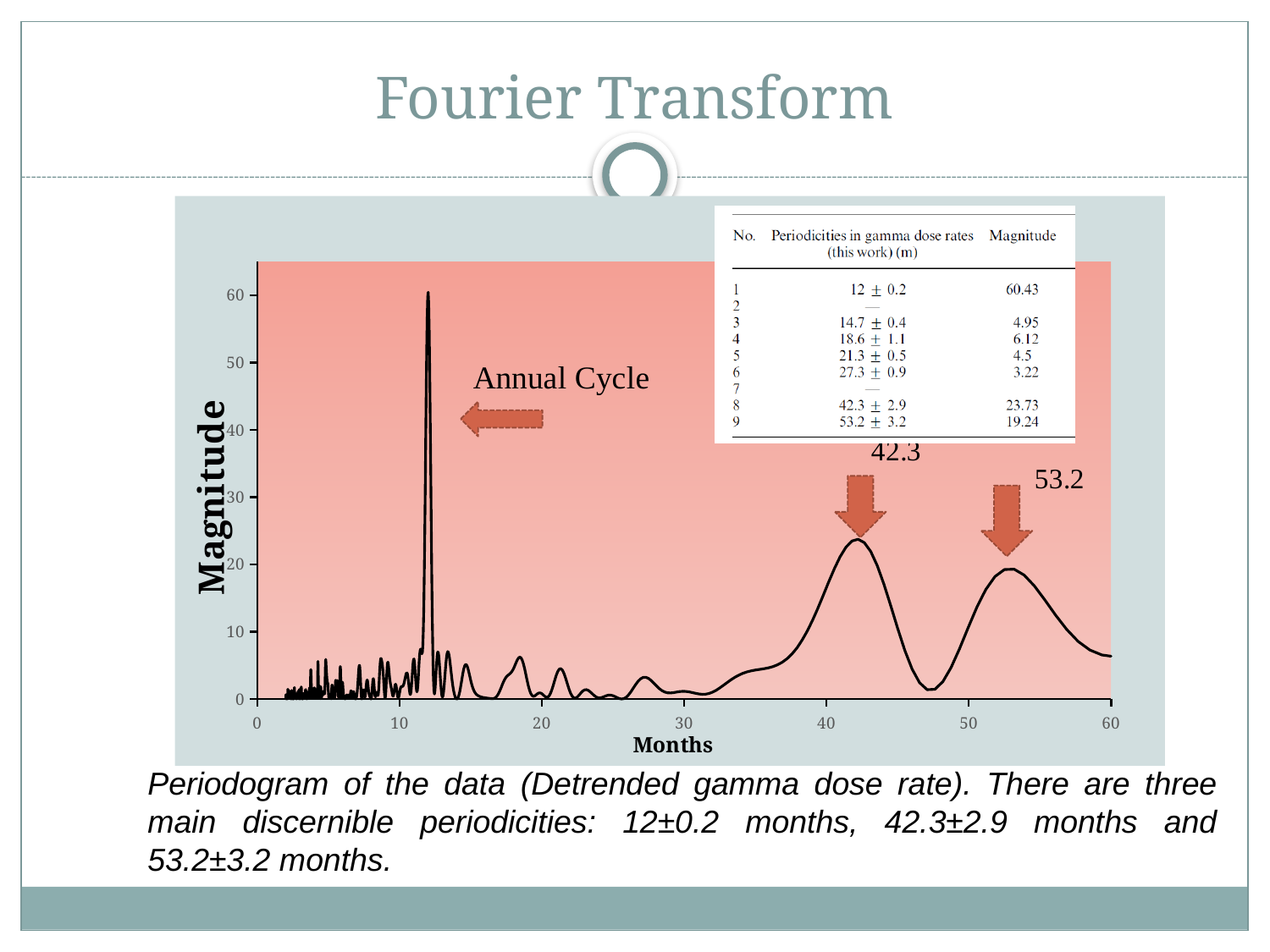
According to the inset table, what is the magnitude of the 12 ± 0.2 month periodicity? 60.43 Is the magnitude of the peak at 53.2 months greater or less than 10? greater What kind of chart is shown on the slide? line chart Is the magnitude of the peak labelled 'Annual Cycle' greater or less than 50? greater What is the label of the y axis of the periodogram? Magnitude According to the inset table, what is the magnitude of the 53.2 ± 3.2 month periodicity? 19.24 According to the inset table, what is the magnitude of the 42.3 ± 2.9 month periodicity? 23.73 Is the magnitude of the peak at 42.3 months greater or less than 30? less What is the label of the x axis of the periodogram? Months Which peak has the larger magnitude, the one at 42.3 months or the one at 53.2 months? 42.3 months How many peaks are marked with arrows on the periodogram? 3